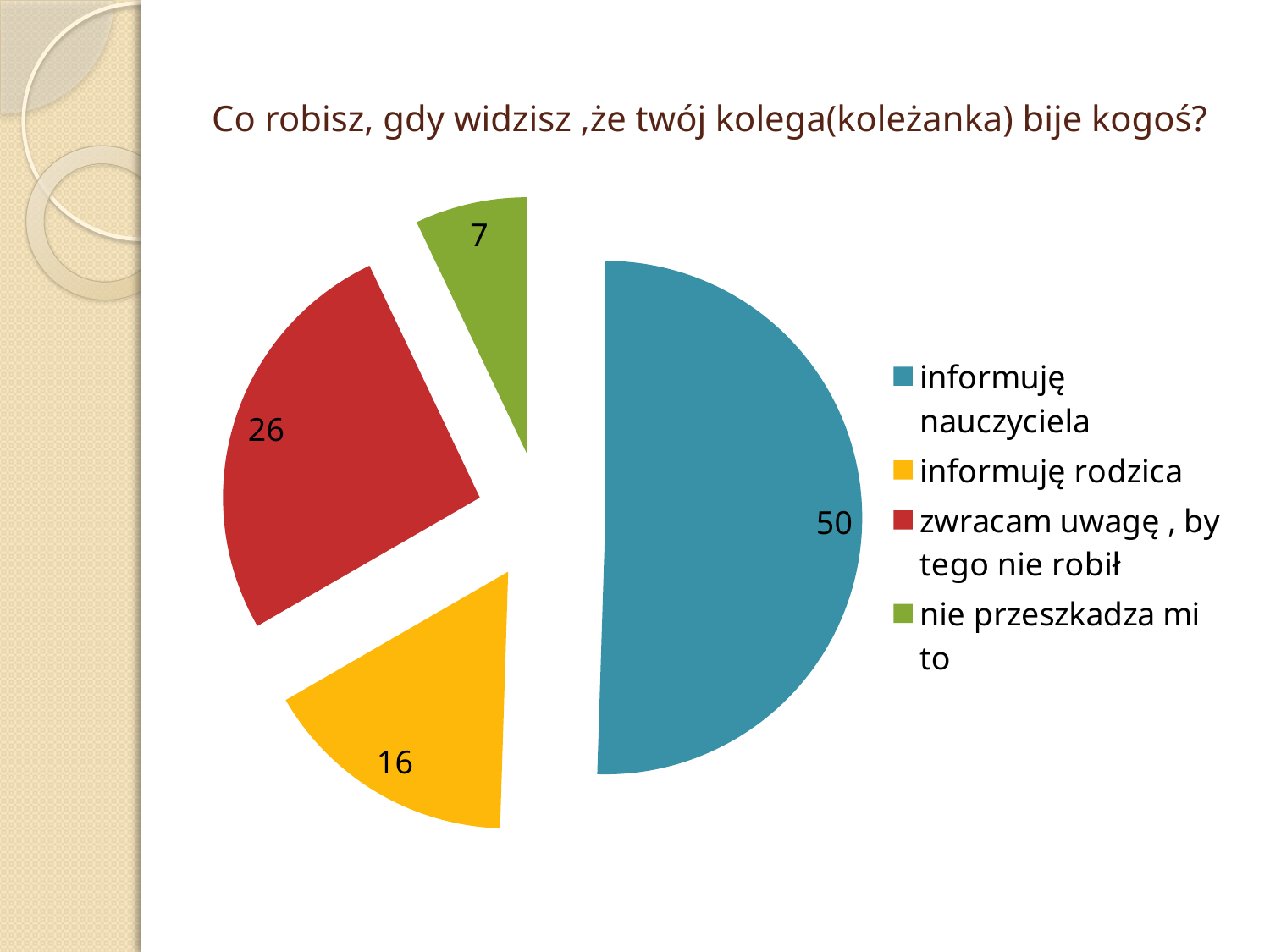
What is the value for "informuję nauczyciela"? 50 How many categories does the pie chart have? 4 What is the value for "nie przeszkadza mi to"? 7 What is the value for "zwracam uwagę , by tego nie robił"? 26 Which category has the largest slice? informuję nauczyciela What is the total of all the values shown in the pie chart? 99 What is the value for "informuję rodzica"? 16 What colour is the slice for "informuję rodzica"? yellow What is the difference between the values for "informuję nauczyciela" and "zwracam uwagę , by tego nie robił"? 24 Which category has the smallest slice? nie przeszkadza mi to Which is larger, the value for "informuję rodzica" or the value for "zwracam uwagę , by tego nie robił"? zwracam uwagę , by tego nie robił What kind of chart is shown on the slide? pie chart